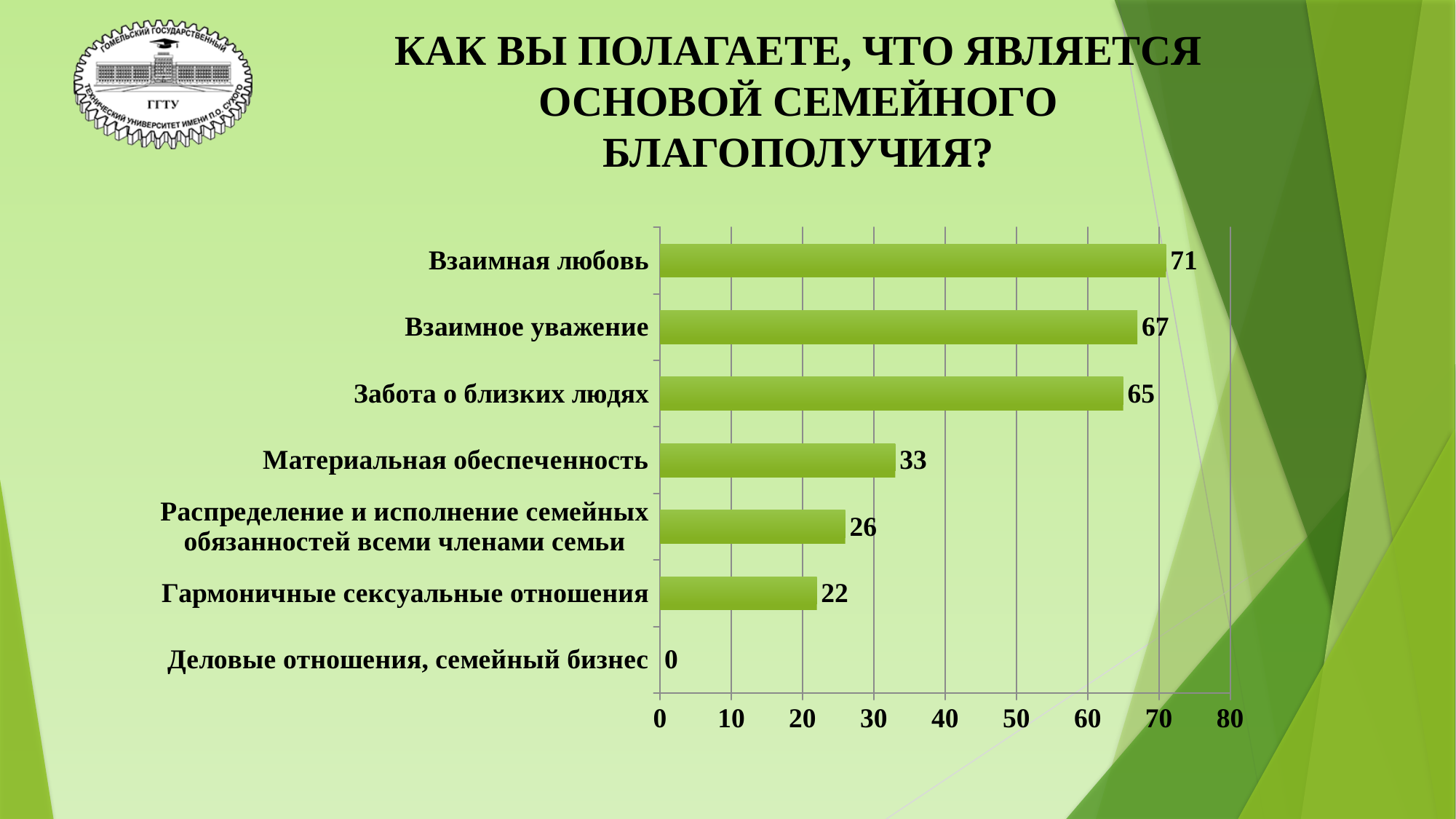
What is the difference between the values for Материальная обеспеченность and Гармоничные сексуальные отношения? 11 How many categories are shown in the chart? 7 What is the value for Материальная обеспеченность? 33 What is the difference between the values for Взаимное уважение and Забота о близких людях? 2 What is the value for Взаимная любовь? 71 What is the value for Гармоничные сексуальные отношения? 22 Which is larger: the value for Материальная обеспеченность or the value for Распределение и исполнение семейных обязанностей всеми членами семьи? Материальная обеспеченность Which category has the lowest value? Деловые отношения, семейный бизнес What kind of chart is shown on the slide? bar chart What is the maximum value shown on the horizontal axis? 80 Which category has the highest value? Взаимная любовь What is the value for Деловые отношения, семейный бизнес? 0